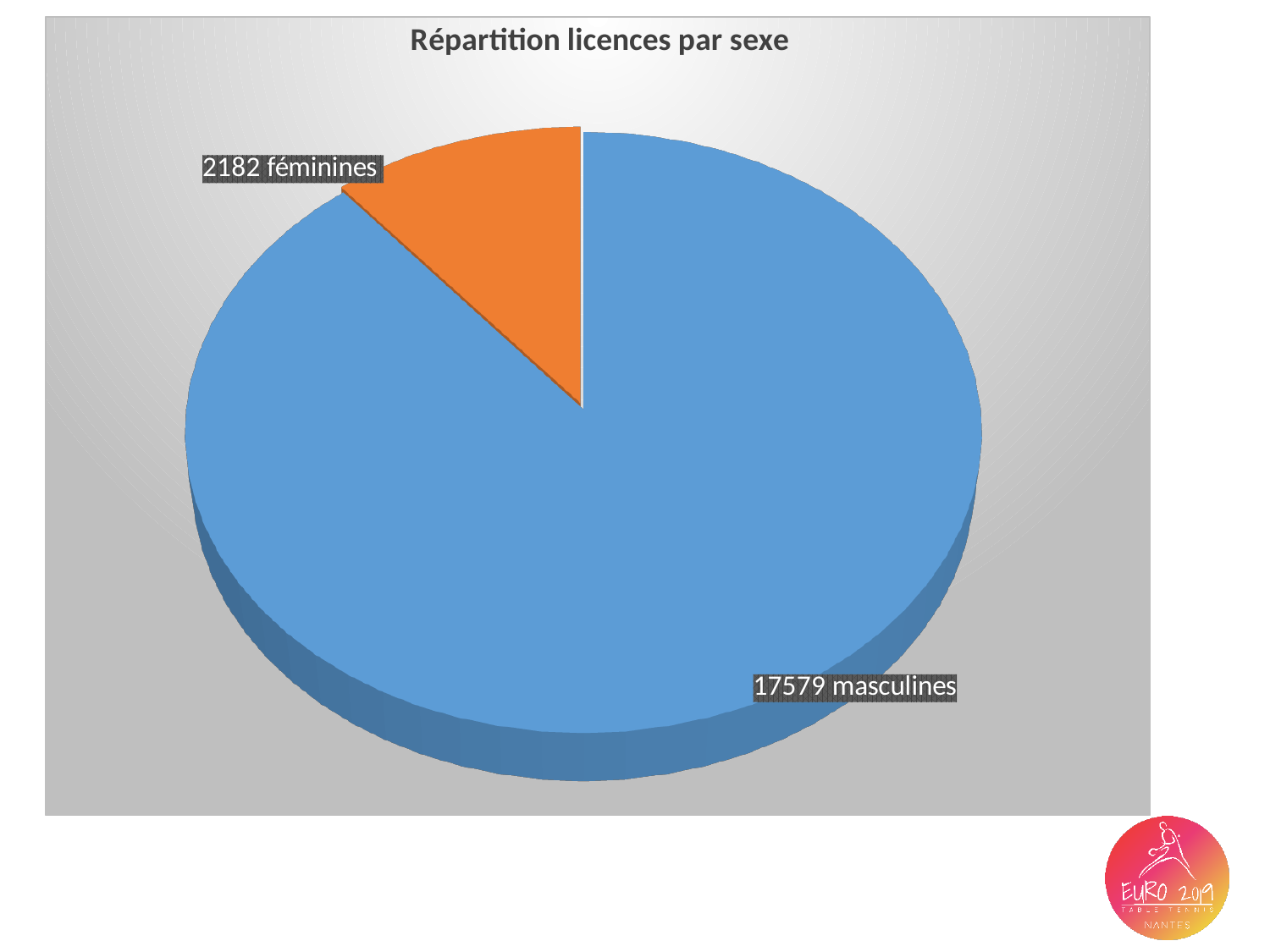
How many slices does the pie chart have? 2 What is the difference between the masculines and féminines licence counts? 15397 Which category has the smallest slice of the pie? féminines How many licences are labelled as féminines? 2182 What share of the total licences do the féminines represent? 11% What kind of chart is shown on the slide? Pie chart What is the total number of licences shown in the pie chart? 19761 Which category has the largest slice of the pie? masculines What is the title of the chart? Répartition licences par sexe How many licences are labelled as masculines? 17579 Which is larger, the number of masculines licences or the number of féminines licences? masculines What colour is the slice for masculines licences? Blue